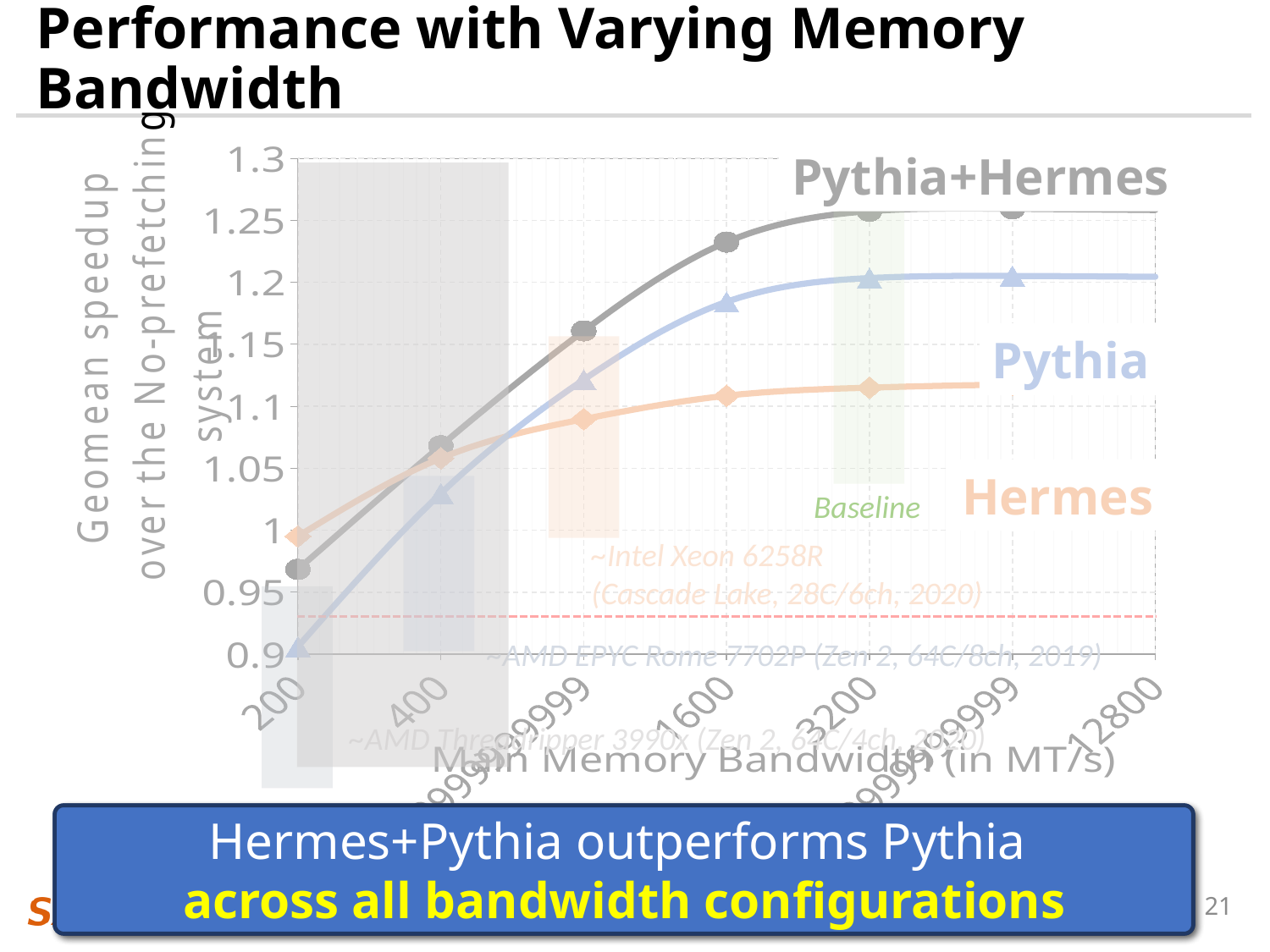
Is the value for Pythia at 200 MT/s greater or less than 0.95? less Is the value for Pythia at 1600 MT/s greater or less than 1.15? greater How many series are plotted in the chart? 3 At 200 MT/s, which series has the higher value: Hermes or Pythia+Hermes? Hermes Is the value for Hermes at 3200 MT/s greater or less than 1.15? less At 3200 MT/s, which series has the higher value: Pythia+Hermes or Pythia? Pythia+Hermes Which series has the lowest value at 200 MT/s? Pythia What is the title of the x axis of the chart? Main Memory Bandwidth (in MT/s) What kind of chart is shown on the slide? line chart Does the Pythia+Hermes series rise or fall as memory bandwidth increases along the x axis? rise Which series has the highest value at 6399.9999 MT/s? Pythia+Hermes